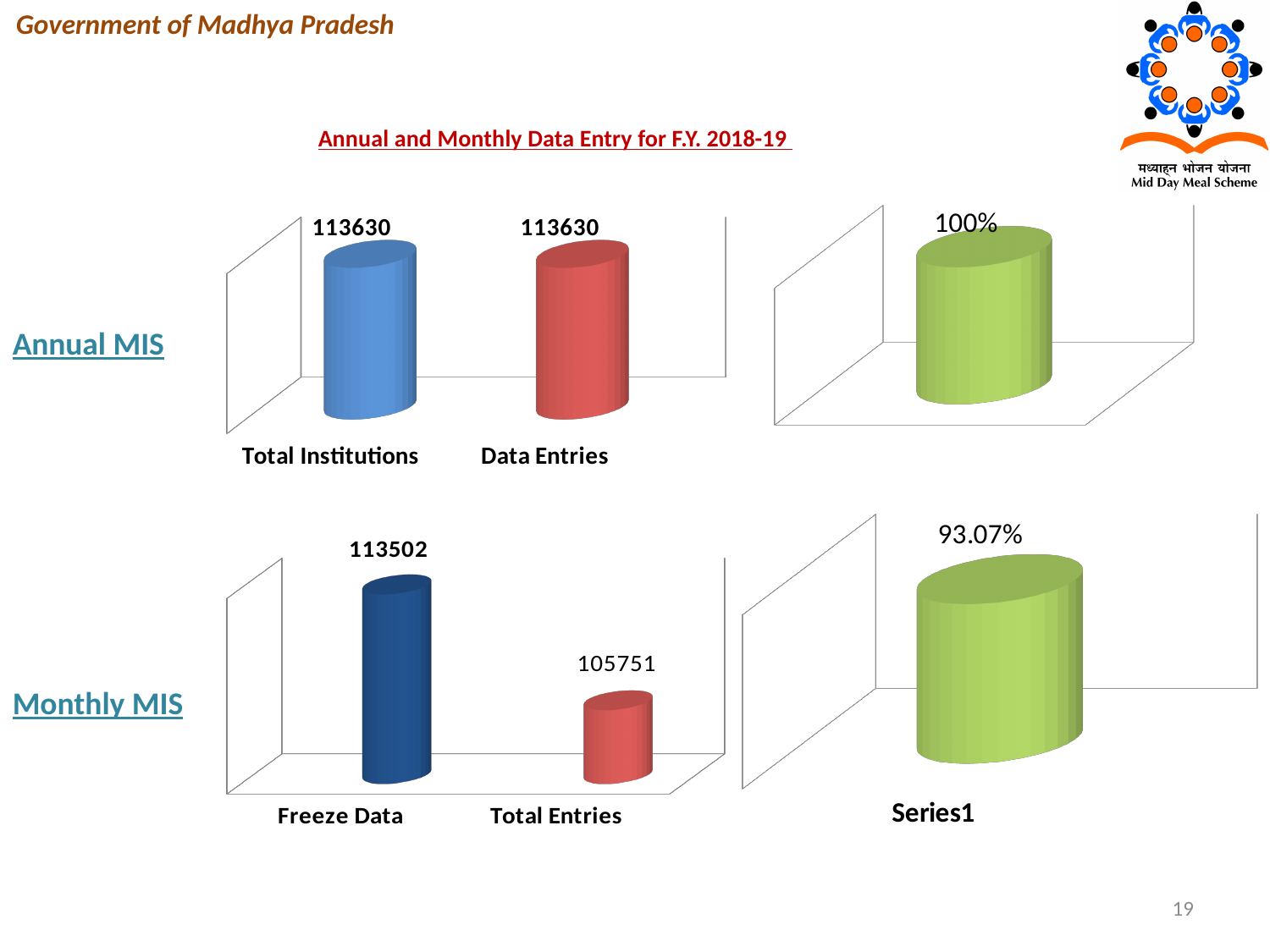
In the Monthly MIS bar chart on the left, what is the value for Freeze Data? 113502 What percentage is shown in the Annual MIS chart on the right? 100% What percentage is shown in the Monthly MIS chart on the right? 93.07% In the Monthly MIS bar chart on the left, what is the value for Total Entries? 105751 How many categories are shown in the Annual MIS bar chart on the left? 2 What type of chart is the Monthly MIS chart on the left? Bar chart In the Annual MIS bar chart on the left, what is the value for Total Institutions? 113630 In the Monthly MIS bar chart on the left, which category has the higher value, Freeze Data or Total Entries? Freeze Data In the Annual MIS bar chart on the left, what is the value for Data Entries? 113630 What is the category label shown under the Monthly MIS chart on the right? Series1 In the Monthly MIS bar chart on the left, which category has the lowest value? Total Entries In the Monthly MIS bar chart on the left, what is the difference between Freeze Data and Total Entries? 7751